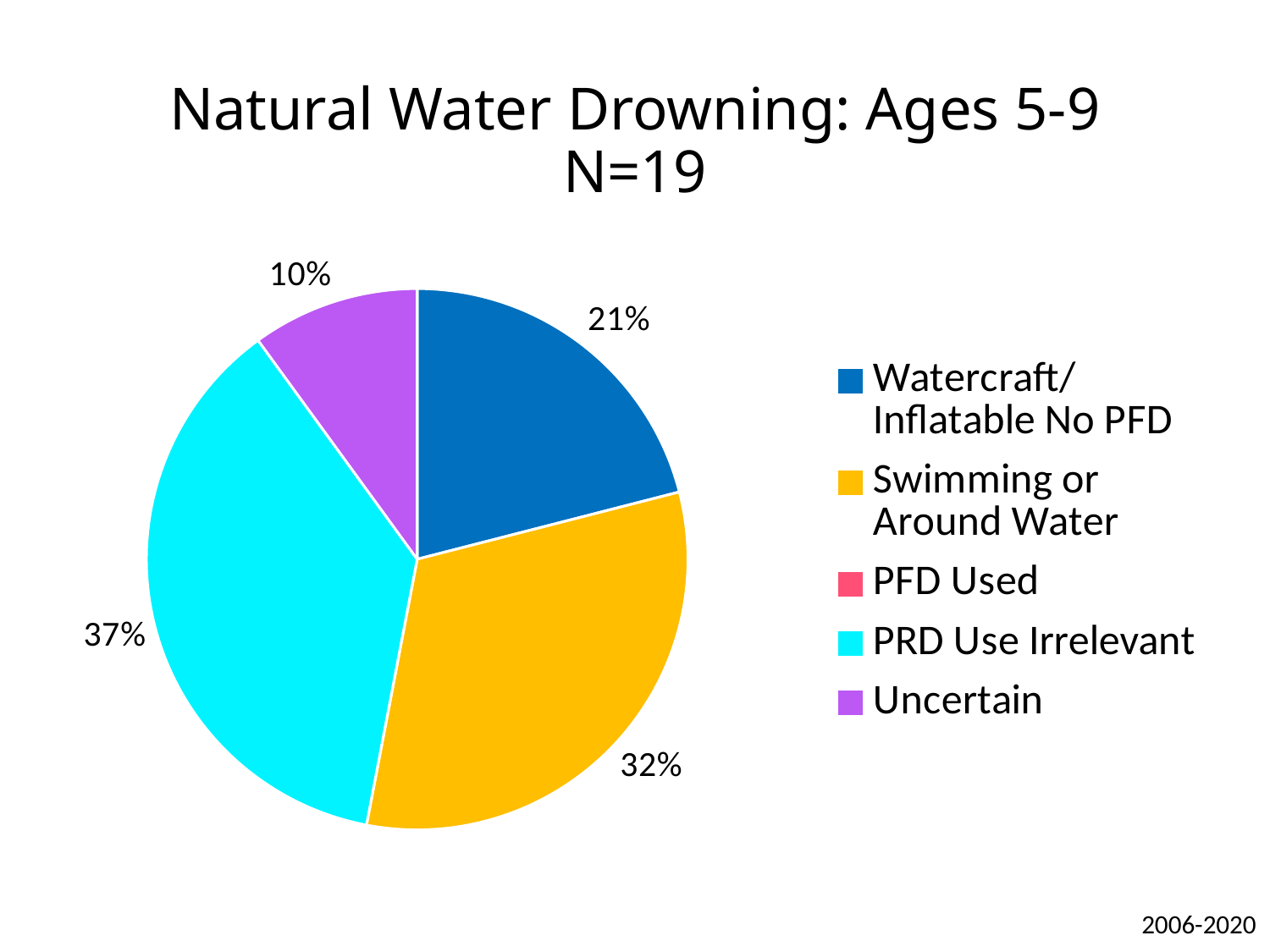
What percentage of the pie is Watercraft/Inflatable No PFD? 21% What colour is the slice for Swimming or Around Water? yellow Which category has the largest share of the pie? PRD Use Irrelevant What percentage of the pie is Uncertain? 10% What is the difference in percentage points between PRD Use Irrelevant and Swimming or Around Water? 5 What percentage of the pie is Swimming or Around Water? 32% What is the title of the chart? Natural Water Drowning: Ages 5-9 N=19 What kind of chart is shown on the slide? pie chart Which is larger: the share for Watercraft/Inflatable No PFD or the share for Uncertain? Watercraft/Inflatable No PFD What percentage of the pie is PRD Use Irrelevant? 37% Which labelled slice has the smallest share of the pie? Uncertain How many entries does the legend list? 5